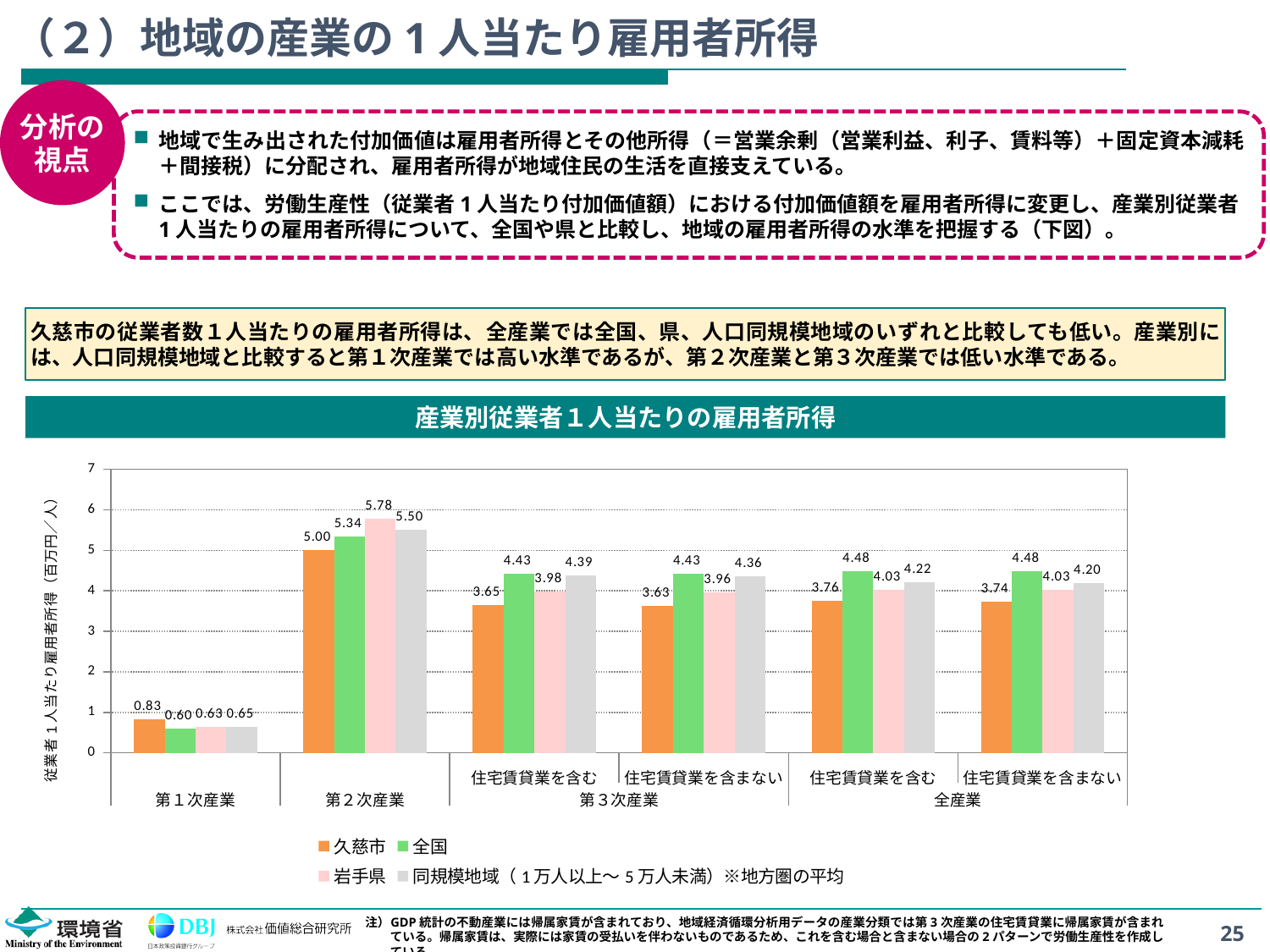
全産業（住宅賃貸業を含まない）における同規模地域の値はいくらですか？ 4.20 全産業（住宅賃貸業を含む）における全国と久慈市の値の差はいくらですか？ 0.72 第１次産業における久慈市の従業者１人当たり雇用者所得はいくらですか？ 0.83 第１次産業において、4つの系列のうち最も低い値を示しているのはどれですか？ 全国 第３次産業（住宅賃貸業を含まない）において、岩手県と同規模地域ではどちらの値が大きいですか？ 同規模地域 第３次産業（住宅賃貸業を含む）における全国の値はいくらですか？ 4.43 このグラフの種類は何ですか？ 棒グラフ 凡例に示されている系列はいくつありますか？ 4 第２次産業における久慈市の値は4より大きいですか、小さいですか？ 大きい 第２次産業における岩手県の値はいくらですか？ 5.78 グラフの縦軸のラベルは何ですか？ 従業者１人当たり雇用者所得（百万円／人） 第２次産業において、4つの系列のうち最も高い値を示しているのはどれですか？ 岩手県